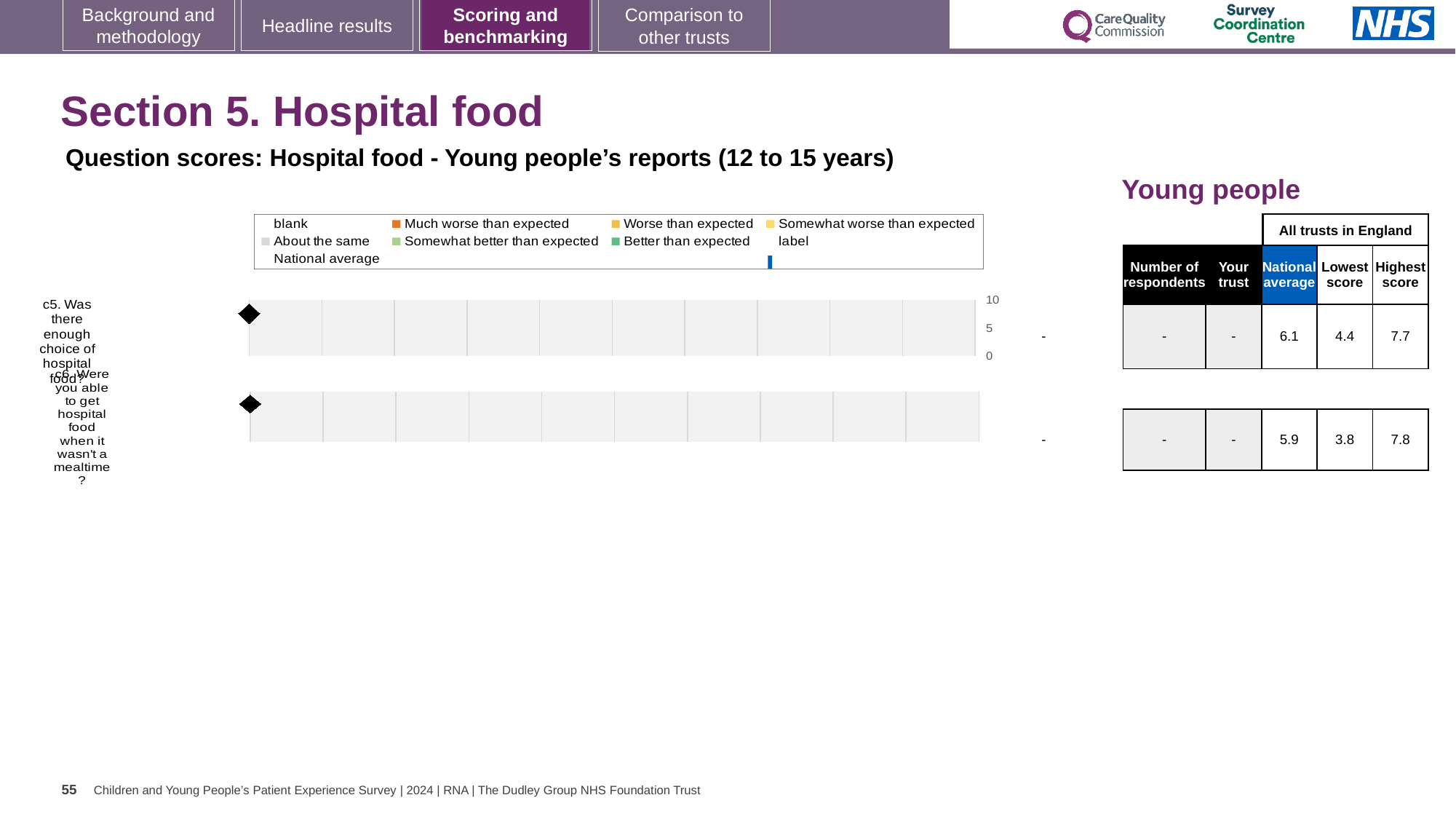
In the table, what is the highest score across all trusts in England for question c5? 7.7 In the table, what is the national average score for question c5 (enough choice of hospital food)? 6.1 Which question has the higher national average score, c5 or c6? c5 How many questions (categories) are plotted on the chart? 2 In the table, what is the highest score across all trusts in England for question c6? 7.8 What is the highest value shown on the chart's axis? 10 What is the difference between the highest and lowest scores for question c6? 4.0 What kind of chart is shown on the slide? bar chart In the table, what is the lowest score across all trusts in England for question c5? 4.4 What colour is the legend entry for 'Much worse than expected'? orange In the table, what is the national average score for question c6 (getting hospital food when it wasn't a mealtime)? 5.9 In the table, what is the lowest score across all trusts in England for question c6? 3.8